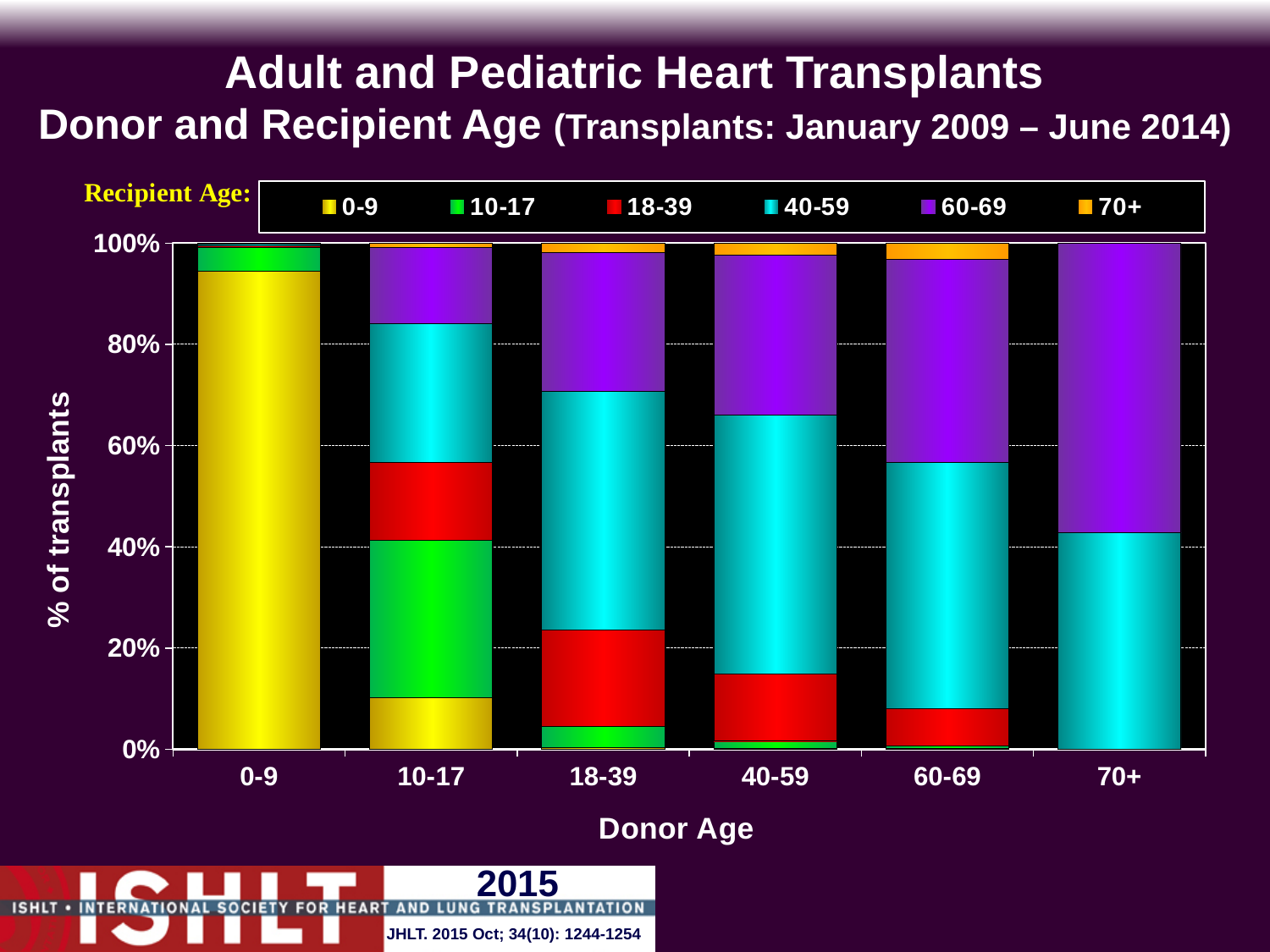
Is the share of 10-17 recipients for donor age 10-17 greater or less than 20%? greater Which donor age group has the largest share of 60-69 recipients? 70+ How many donor age categories are shown on the x axis? 6 Is the share of 60-69 recipients for donor age 70+ greater or less than 40%? greater For donor age 10-17, which recipient group has the larger share: 10-17 or 18-39? 10-17 What is the label of the x axis? Donor Age Is the share of 0-9 recipients for donor age 0-9 greater or less than 80%? greater Which donor age group has the largest share of 0-9 recipients? 0-9 How many recipient age groups does the legend list? 6 What kind of chart is shown on the slide? Stacked bar chart What is the label of the y axis? % of transplants